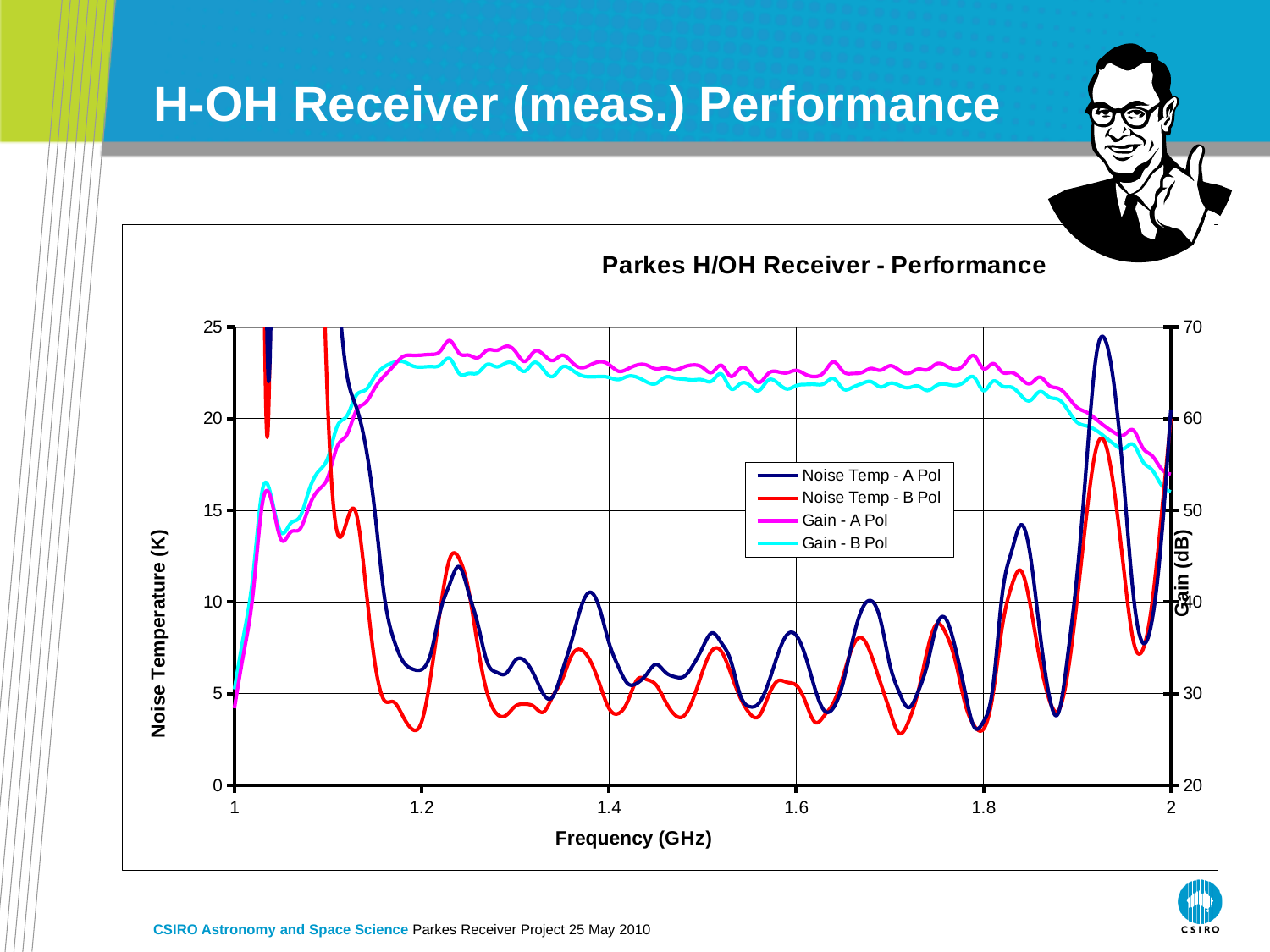
Is the value of Gain - A Pol at 1.4 GHz greater or less than 60 dB? greater Is the peak of Noise Temp - A Pol near 1.92 GHz greater or less than 20 K? greater Is the value of Noise Temp - A Pol at 1.6 GHz greater or less than 10 K? less Does Gain - A Pol rise or fall between 1.8 GHz and 2 GHz? fall At 1.4 GHz, which is higher: Gain - A Pol or Gain - B Pol? Gain - A Pol What is the title of the chart? Parkes H/OH Receiver - Performance How many series does the chart legend list? 4 Does Gain - B Pol rise or fall between 1 GHz and 1.2 GHz? rise What kind of chart is shown on the slide? Line chart What is the label of the left vertical axis? Noise Temperature (K)